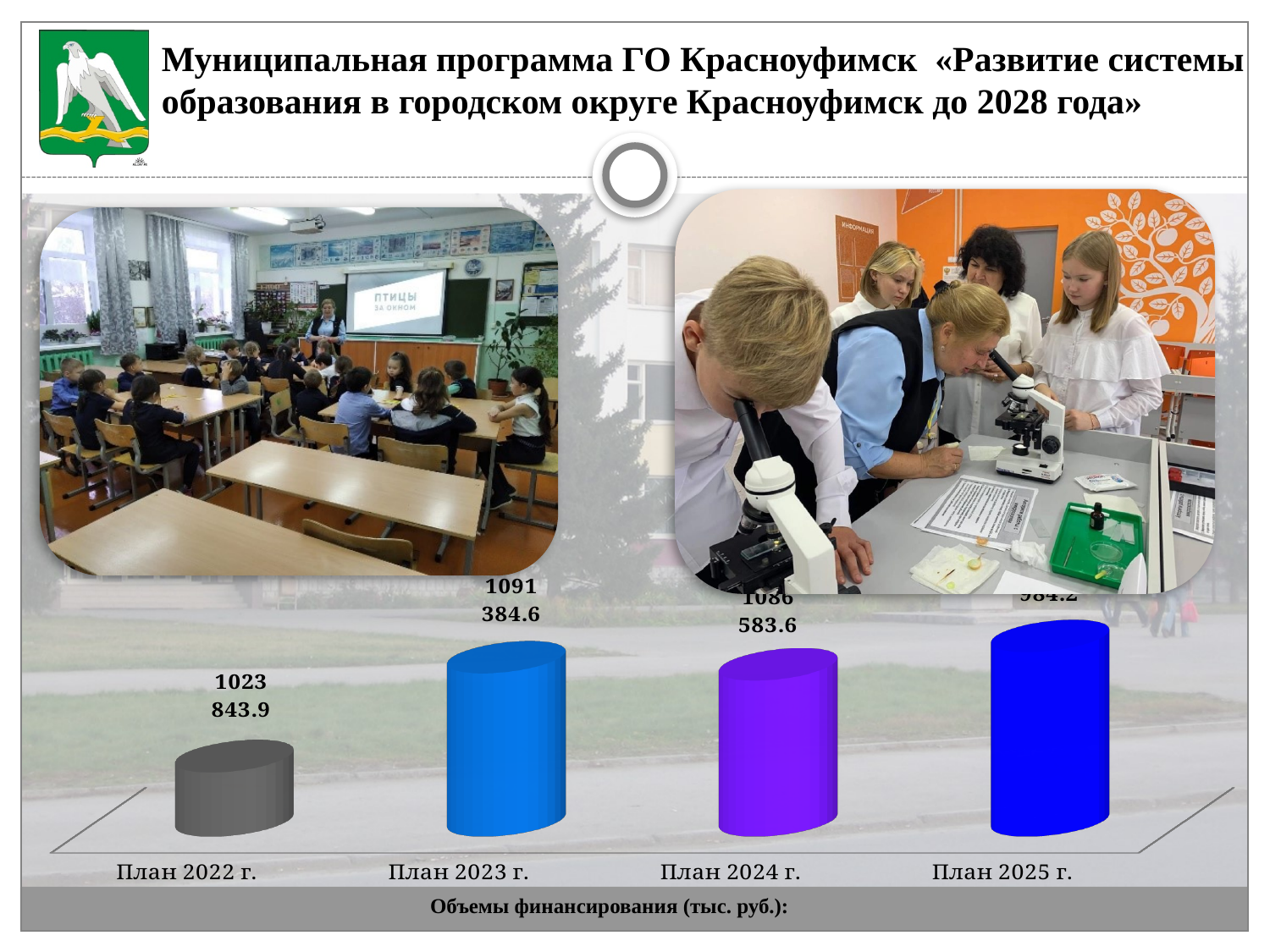
How many categories are plotted in the chart? 4 What unit is stated in the caption below the chart? тыс. руб. Which category has the lowest bar in the chart? План 2022 г. Which is larger, the value for План 2023 г. or the value for План 2022 г.? План 2023 г. What is the planned funding value shown for План 2023 г.? 1091 384.6 What kind of chart is shown on the slide? bar chart What colour is the bar for План 2022 г.? grey What is the difference between the values for План 2023 г. and План 2022 г.? 67 540.7 What is the planned funding value shown for План 2022 г.? 1023 843.9 Do the bar values generally rise or fall from План 2022 г. to План 2025 г.? rise Which category has the highest bar in the chart? План 2025 г.